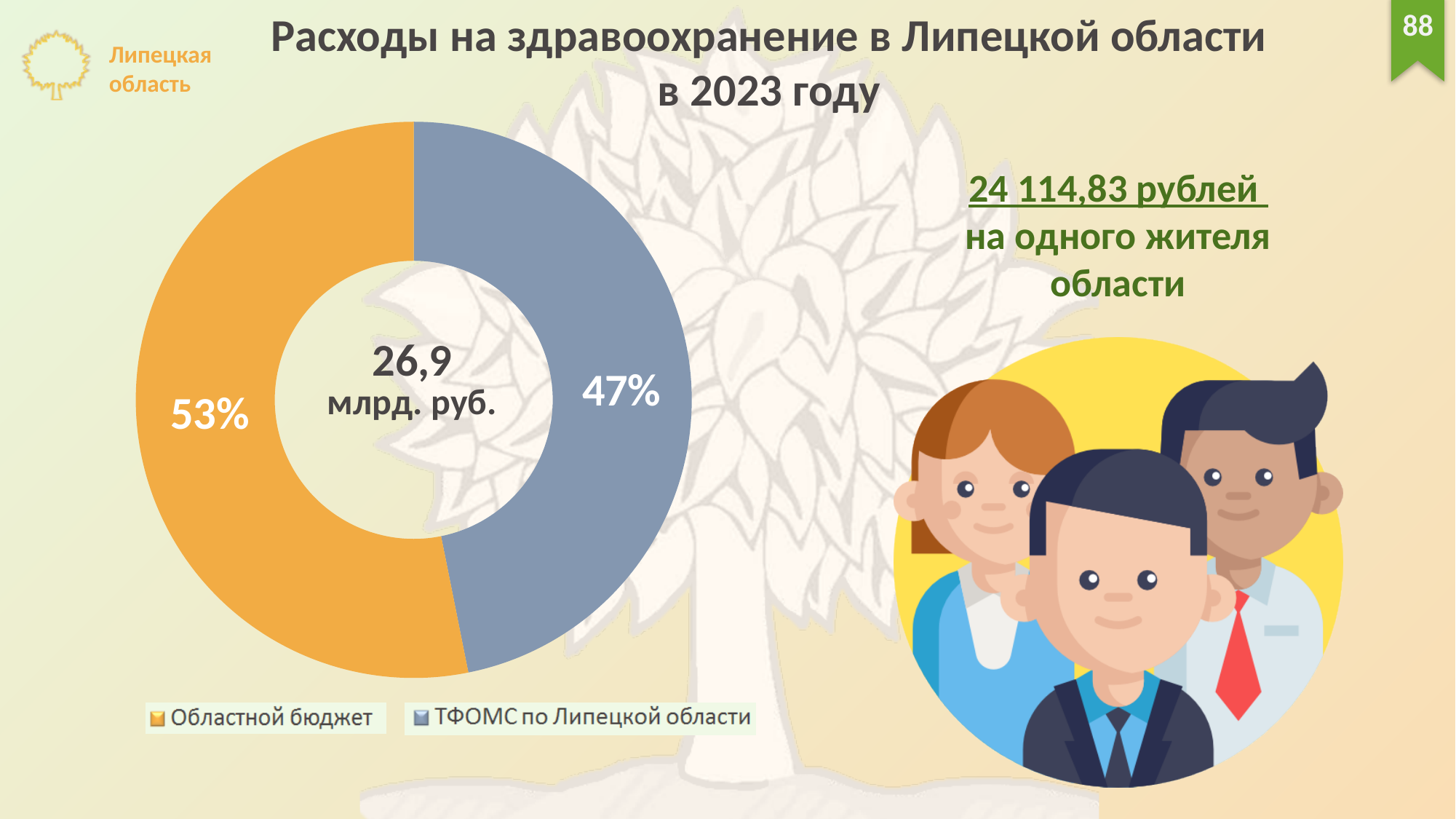
Which category has the smallest share in the chart? ТФОМС по Липецкой области Which colour represents Областной бюджет in the chart? Orange What kind of chart is shown on the slide? Pie (donut) chart What is the title of the chart on the slide? Расходы на здравоохранение в Липецкой области в 2023 году What is the difference in percentage points between the Областной бюджет share and the ТФОМС по Липецкой области share? 6 percentage points Which category has the largest share in the chart? Областной бюджет What share of the chart does ТФОМС по Липецкой области account for? 47% What total value is printed in the centre of the chart? 26,9 млрд. руб. What share of the chart does Областной бюджет account for? 53% How many categories does the chart show? 2 Which is larger: the share for Областной бюджет or the share for ТФОМС по Липецкой области? Областной бюджет How many entries does the chart legend list? 2